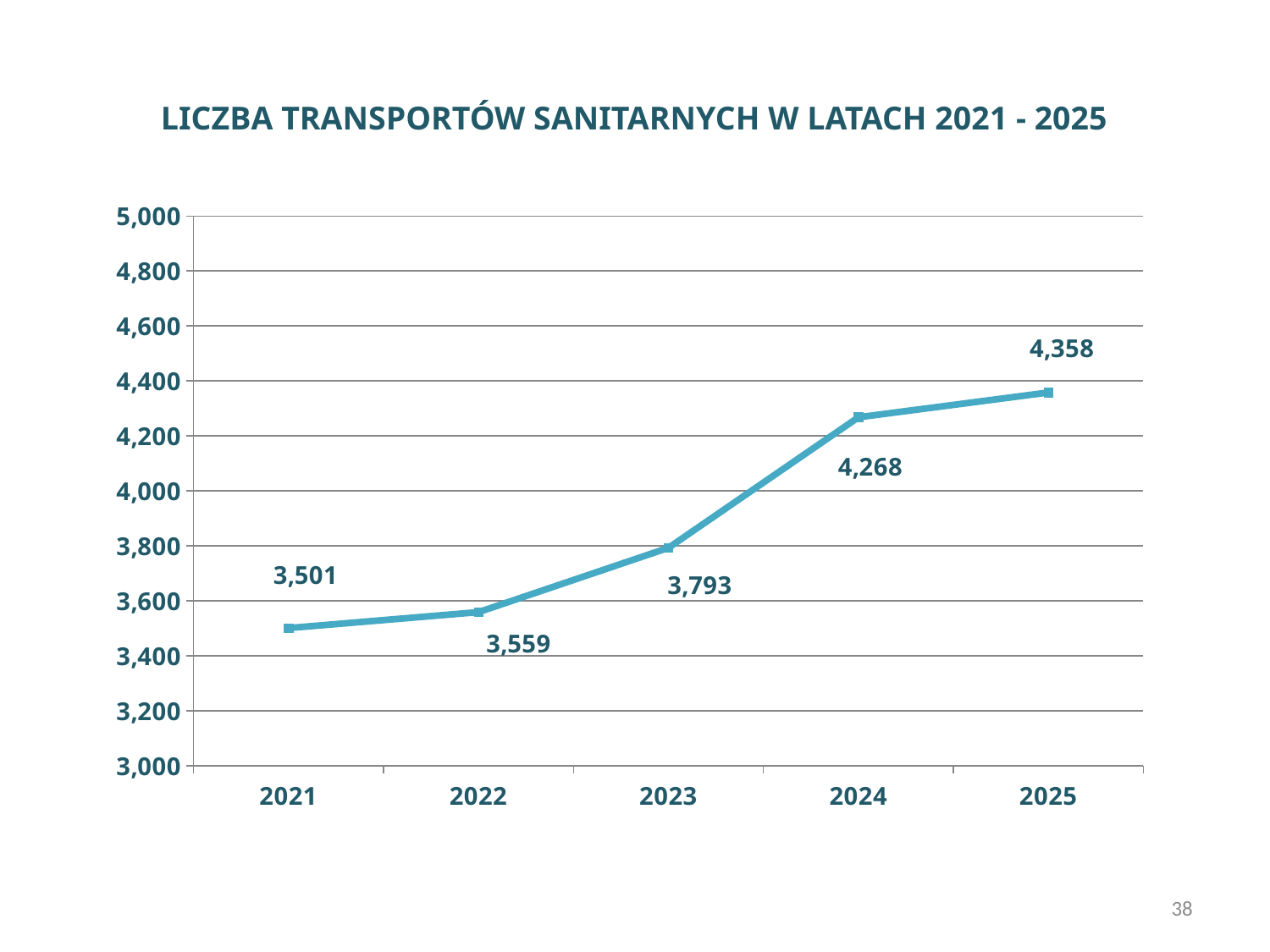
What kind of chart is shown on the slide? line chart What is the value for 2021? 3,501 How many years are plotted on the chart? 5 Is the value for 2023 greater or less than 3,600? greater What is the value for 2023? 3,793 Which is larger, the value for 2024 or the value for 2022? 2024 Which year has the highest value? 2025 What is the difference between the values for 2024 and 2023? 475 What is the difference between the values for 2022 and 2021? 58 Which year has the lowest value? 2021 Do the values rise or fall from 2021 to 2025? rise What is the value for 2025? 4,358